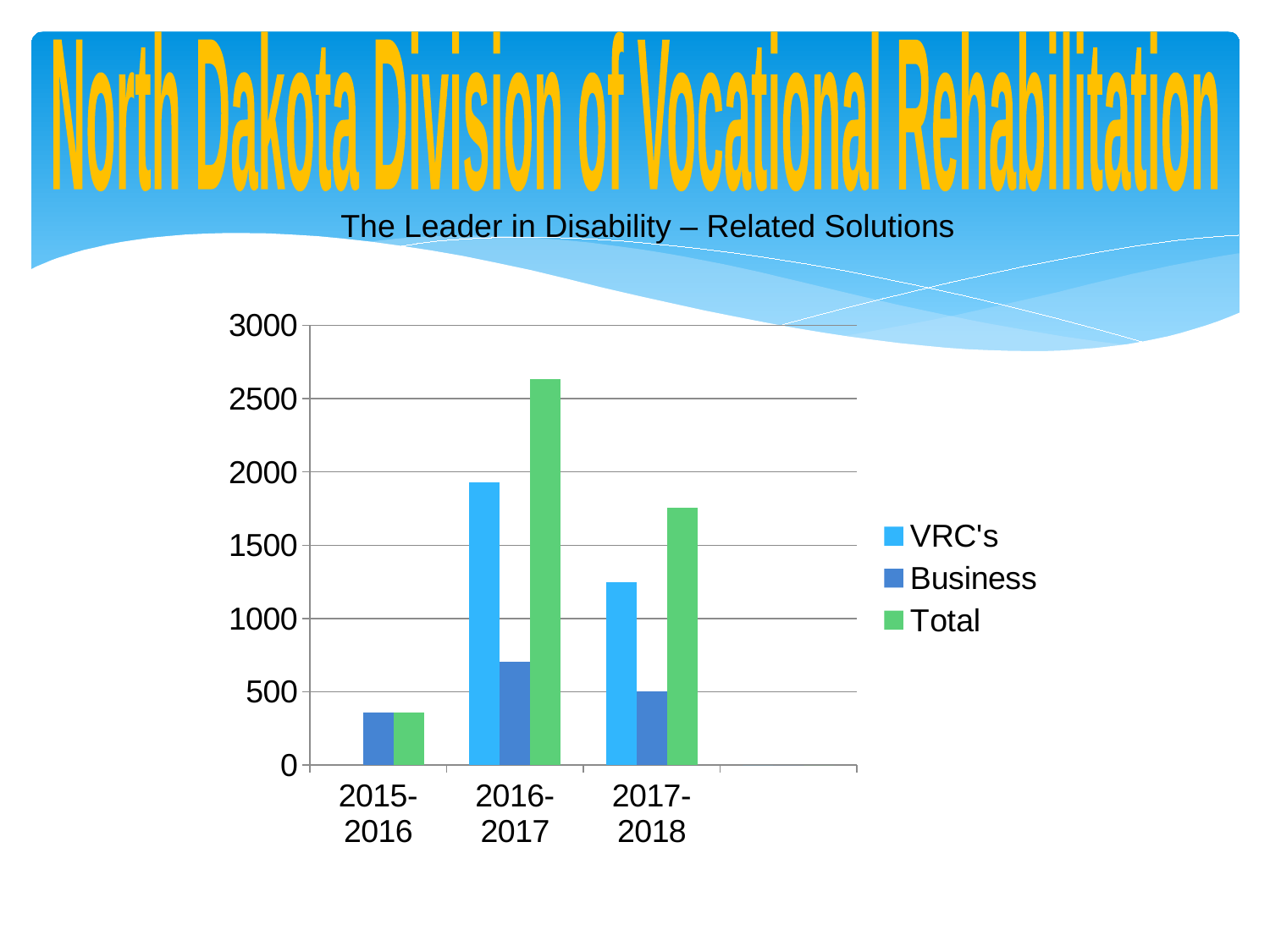
What kind of chart is shown on the slide? bar chart Which year has the lowest Total value? 2015-2016 Which year has the highest VRC's value? 2016-2017 Does the Total value rise or fall from 2016-2017 to 2017-2018? fall Is the VRC's value for 2017-2018 greater or less than 1500? less Which colour represents the Total series in the legend? green Which is larger, the Business value for 2016-2017 or the Business value for 2017-2018? 2016-2017 Is the Business value for 2016-2017 greater or less than 500? greater Which year has the highest Total value? 2016-2017 Is the Total value for 2016-2017 greater or less than 2500? greater How many series does the legend list? 3 How many year categories are shown on the x axis? 3